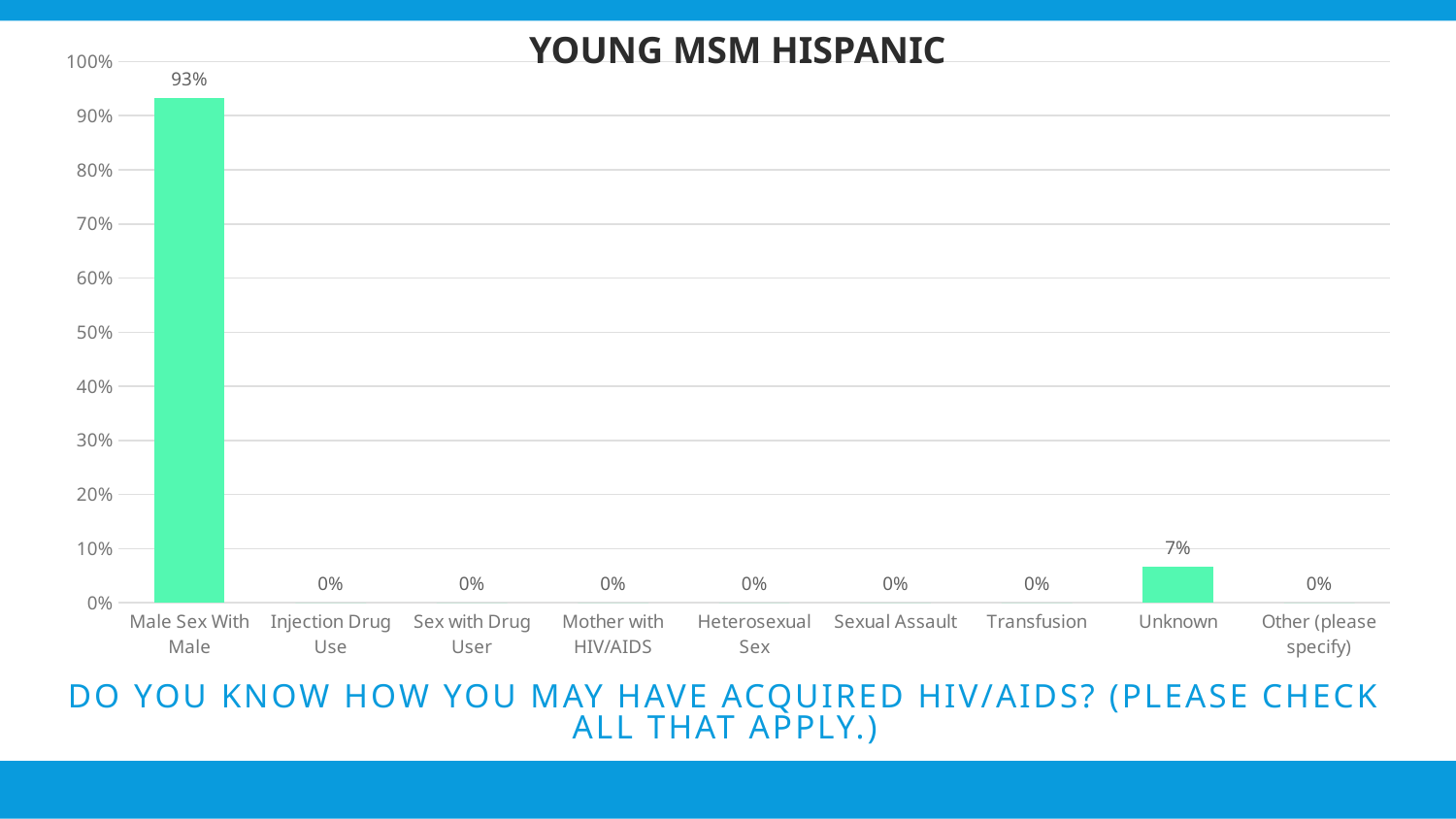
What is the difference between the values for Male Sex With Male and Unknown? 86% What is the value for Unknown? 7% Which category has the highest value? Male Sex With Male Is the value for Male Sex With Male greater or less than 90%? greater What is the value for Male Sex With Male? 93% Which is larger, the value for Unknown or the value for Transfusion? Unknown What kind of chart is shown on the slide? bar chart What is the title of the chart? YOUNG MSM HISPANIC What is the value for Heterosexual Sex? 0% How many categories are shown on the x axis? 9 How many categories have a value of 0%? 7 Is the value for Unknown greater or less than 10%? less